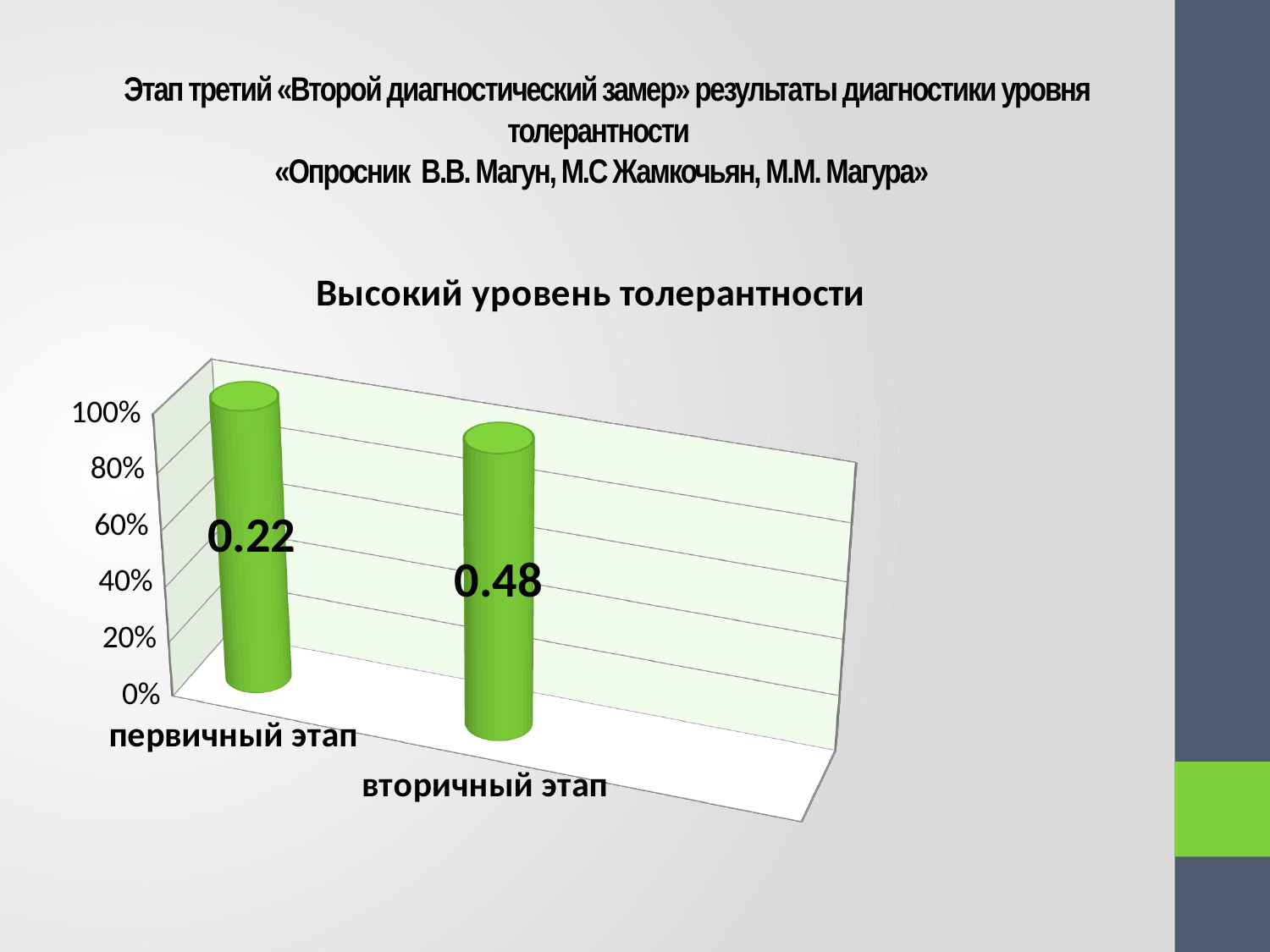
Which category has the lowest value? первичный этап What is the value for вторичный этап? 0.48 What colour are the bars in the chart? green Which is larger, the value for первичный этап or the value for вторичный этап? вторичный этап What is the difference between the values for вторичный этап and первичный этап? 0.26 How many categories are shown in the chart? 2 What kind of chart is shown on the slide? bar chart Which category has the highest value? вторичный этап Do the values rise or fall from первичный этап to вторичный этап? rise What is the title of the chart? Высокий уровень толерантности What is the value for первичный этап? 0.22